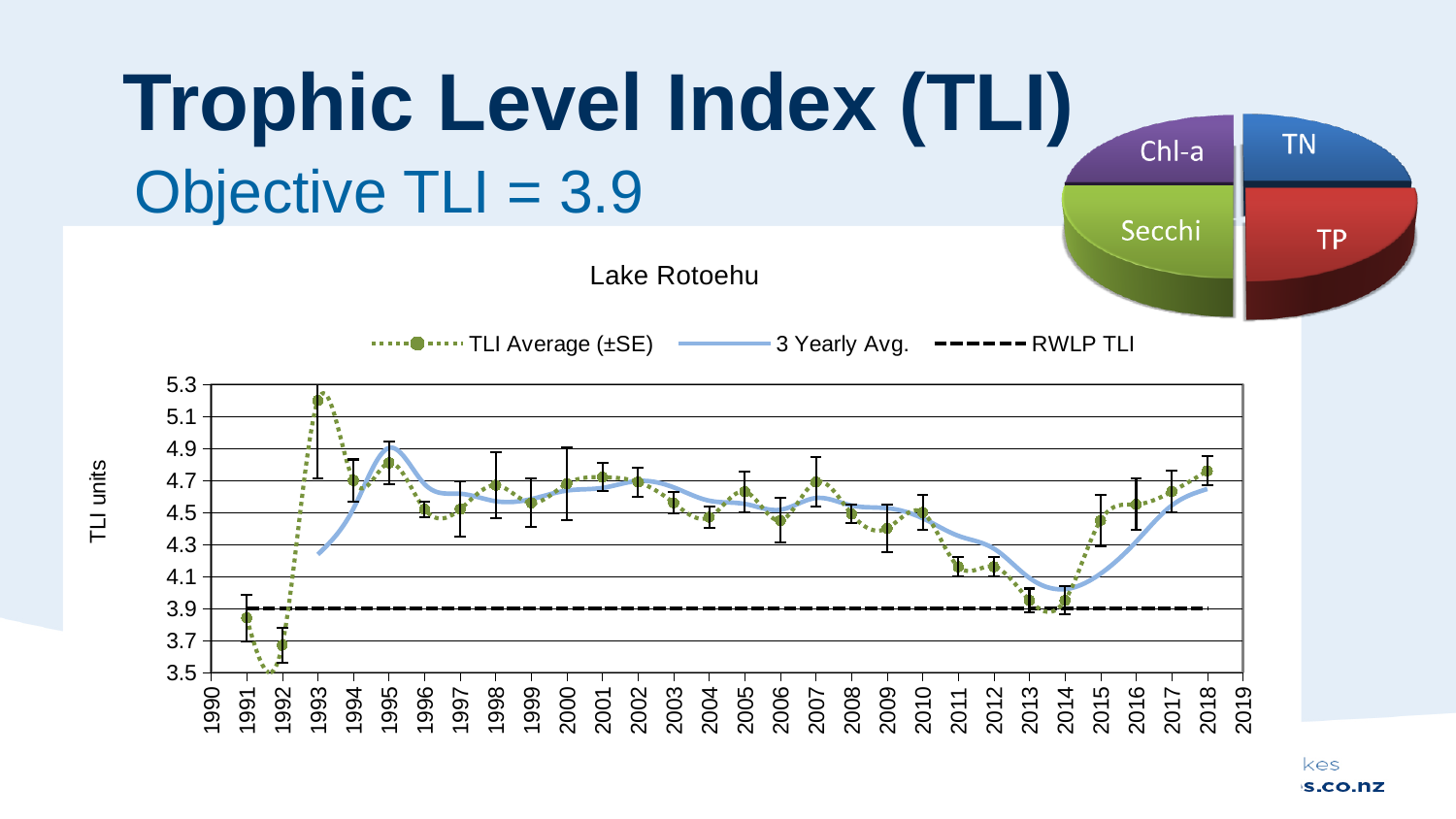
What is the label on the vertical axis of the Lake Rotoehu chart? TLI units In the Lake Rotoehu chart, which year has the highest TLI Average? 1993 In the Lake Rotoehu chart, which year has the lowest TLI Average? 1992 In the Lake Rotoehu chart, is the TLI Average for 2014 greater or less than 4.1? less In the Lake Rotoehu chart, how many series does the legend list? 3 In the Lake Rotoehu chart, what kind of chart is used to show the TLI data? line chart In the Lake Rotoehu chart, is the TLI Average for 1993 greater or less than 5.1? greater In the Lake Rotoehu chart, is the TLI Average for 1992 greater or less than 3.9? less How many slices does the pie chart in the top right corner of the slide have? 4 In the Lake Rotoehu chart, does the TLI Average rise or fall from 2014 to 2018? rise In the Lake Rotoehu chart, what value does the RWLP TLI dashed line sit at? 3.9 In the Lake Rotoehu chart, which year has the larger TLI Average, 2011 or 2016? 2016